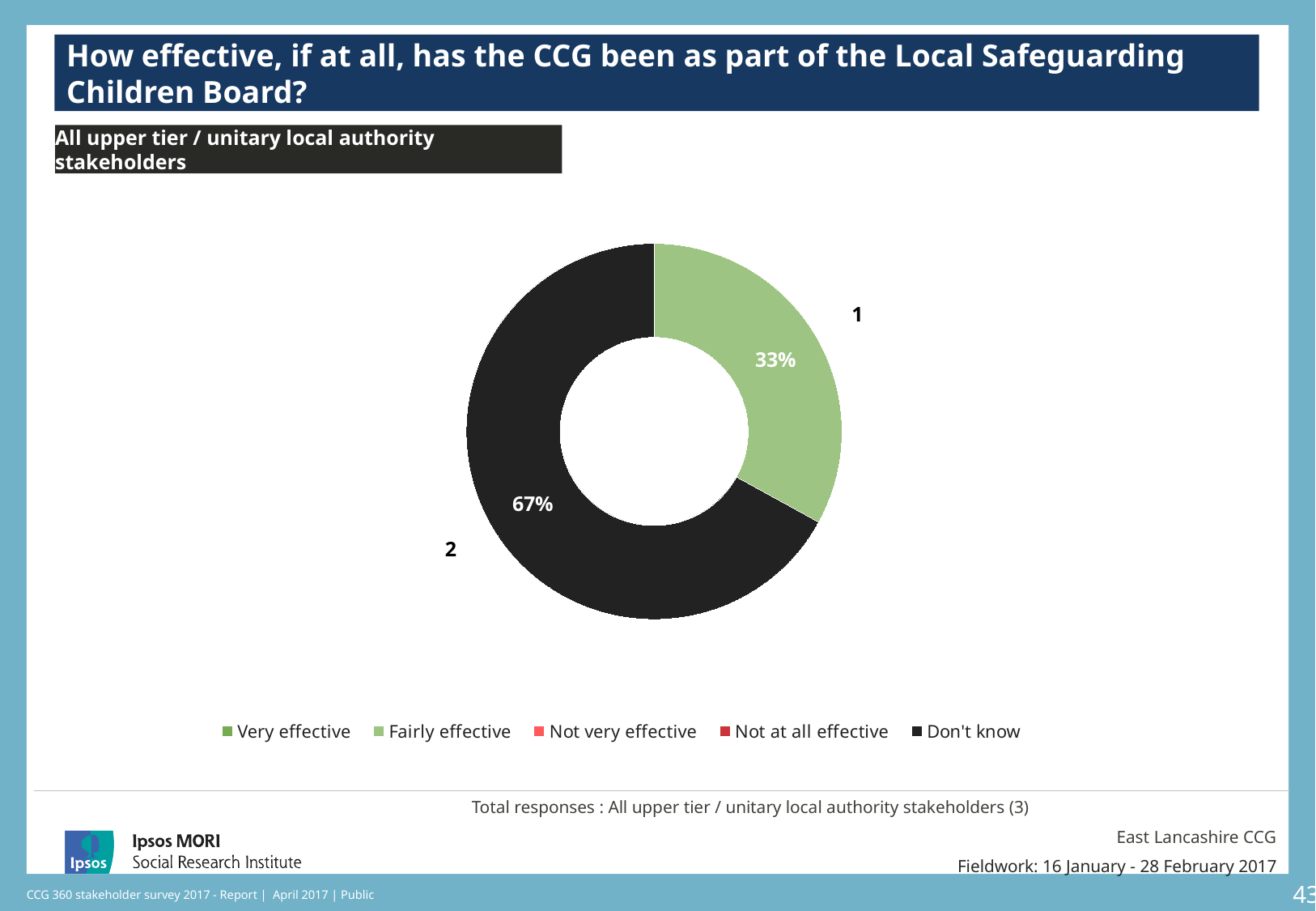
What percentage of respondents answered 'Don't know'? 67% How many respondents answered 'Fairly effective'? 1 What kind of chart is shown on the slide? Pie chart (donut) How many respondents answered 'Don't know'? 2 Which of the two plotted categories has the smaller share, 'Fairly effective' or 'Don't know'? Fairly effective What percentage of respondents answered 'Fairly effective'? 33% How many response categories does the legend list? 5 Is the share for 'Don't know' larger or smaller than the share for 'Fairly effective'? Larger Which response category has the largest share of the chart? Don't know What is the difference in percentage points between the 'Don't know' and 'Fairly effective' shares? 34 percentage points What is the total number of responses shown for the chart? 3 How many slices are visible in the chart? 2